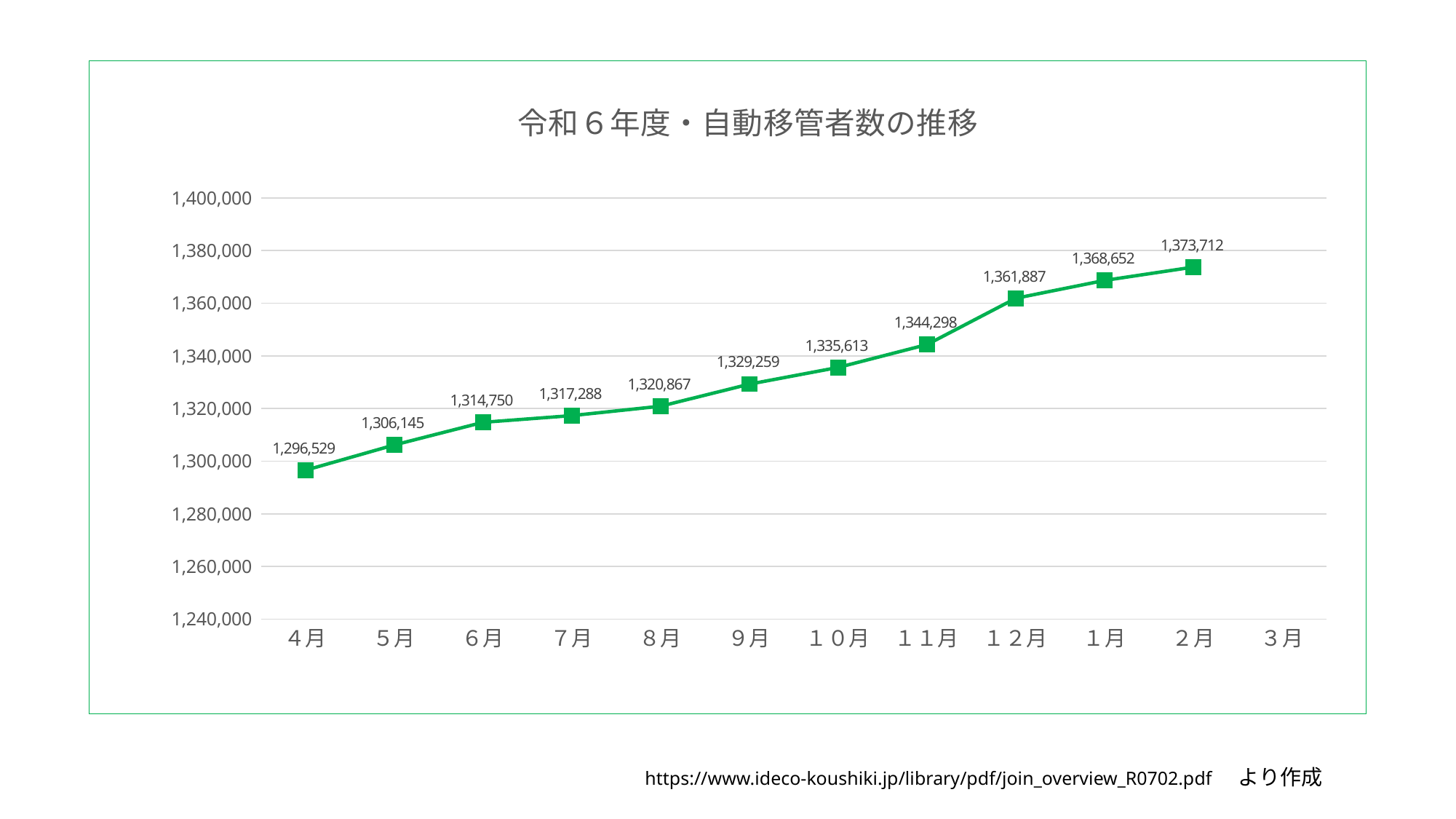
What is the difference between the values for 2月 and 4月? 77,183 Which is larger, the value for 9月 or the value for 7月? 9月 What is the value for 10月? 1,335,613 What kind of chart is shown on the slide? line chart How many data points are plotted on the line? 11 What is the value for 4月? 1,296,529 What is the difference between the values for 12月 and 11月? 17,589 Which month has the highest value? 2月 What is the value for 2月? 1,373,712 Is the value for 12月 greater or less than 1,360,000? greater Do the values rise or fall from 4月 to 2月? rise Which month has the lowest value? 4月